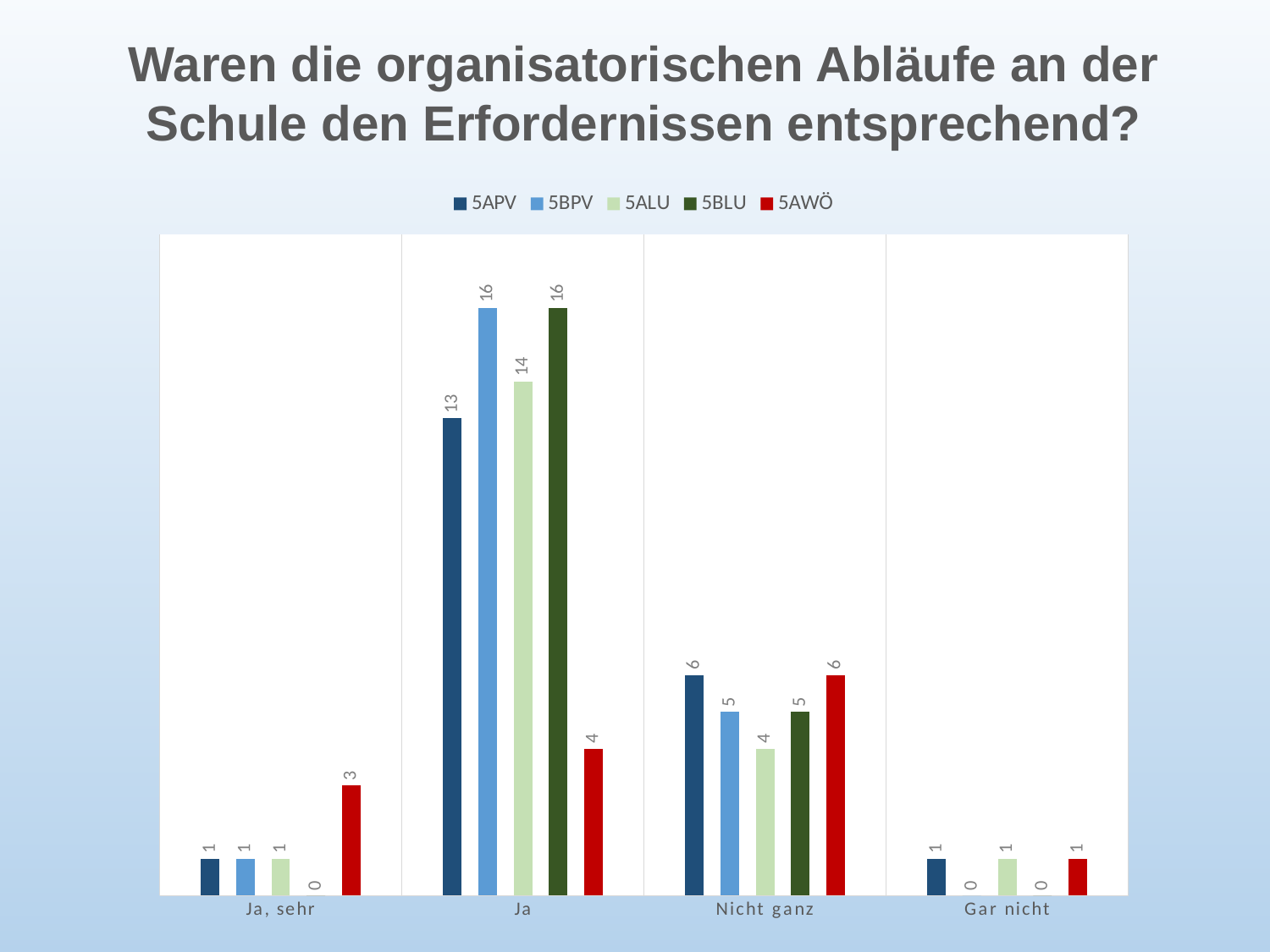
What is the value for 5AWÖ in the "Ja, sehr" category? 3 What kind of chart is shown on the slide? Bar chart What is the value for 5APV in the "Ja" category? 13 What is the difference between the 5BPV and 5APV values in the "Ja" category? 3 What is the total of the 5ALU values across all four categories? 20 How many categories are shown on the x axis? 4 In the "Nicht ganz" category, which is larger: the value for 5APV or the value for 5BPV? 5APV Which series has the lowest value in the "Ja" category? 5AWÖ How many series does the legend list? 5 What is the value for 5BLU in the "Gar nicht" category? 0 Which series has the highest value in the "Ja, sehr" category? 5AWÖ What is the value for 5ALU in the "Nicht ganz" category? 4